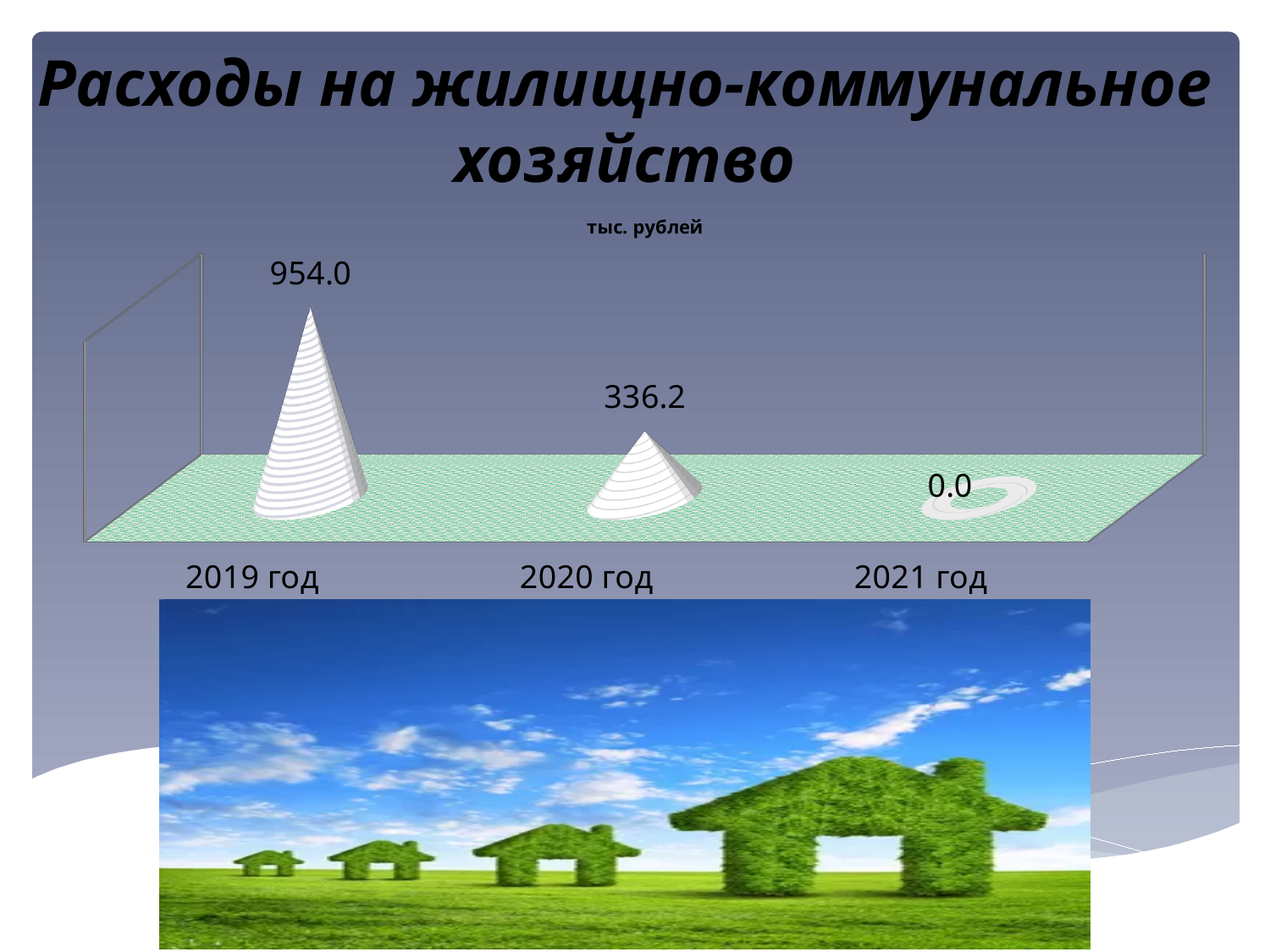
What is the value for 2021 год? 0.0 What is the value for 2020 год? 336.2 Do the values rise or fall from 2019 год to 2021 год? fall What is the value for 2019 год? 954.0 Which is larger, the value for 2019 год or 2020 год? 2019 год How many years are shown on the chart? 3 What is the difference between the values for 2019 год and 2020 год? 617.8 What is the title of the slide? Расходы на жилищно-коммунальное хозяйство What unit is stated above the chart? тыс. рублей Which year has the highest value? 2019 год Which year has the lowest value? 2021 год